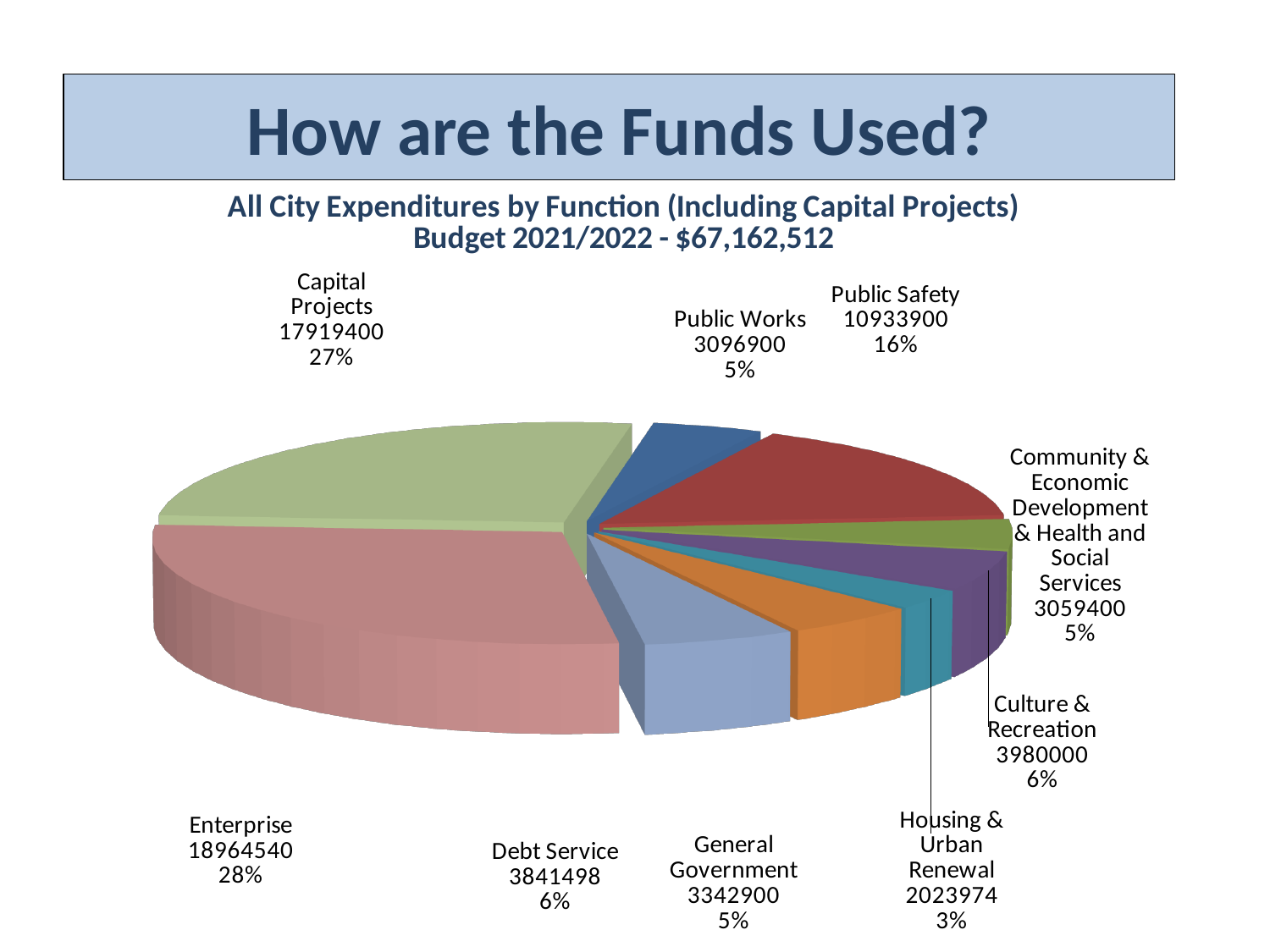
Which category has the largest value? Enterprise How many categories are shown in the pie chart? 9 What is the value for Housing & Urban Renewal? 2023974 What is the difference between the values for Enterprise and Capital Projects? 1045140 Which is larger, the value for Debt Service or the value for General Government? Debt Service What percentage share does Capital Projects have? 27% What is the value for Enterprise? 18964540 What percentage share does Culture & Recreation have? 6% What is the value for Public Safety? 10933900 What total budget amount is stated in the chart title? $67,162,512 Which category has the smallest value? Housing & Urban Renewal What kind of chart is shown on the slide? Pie chart